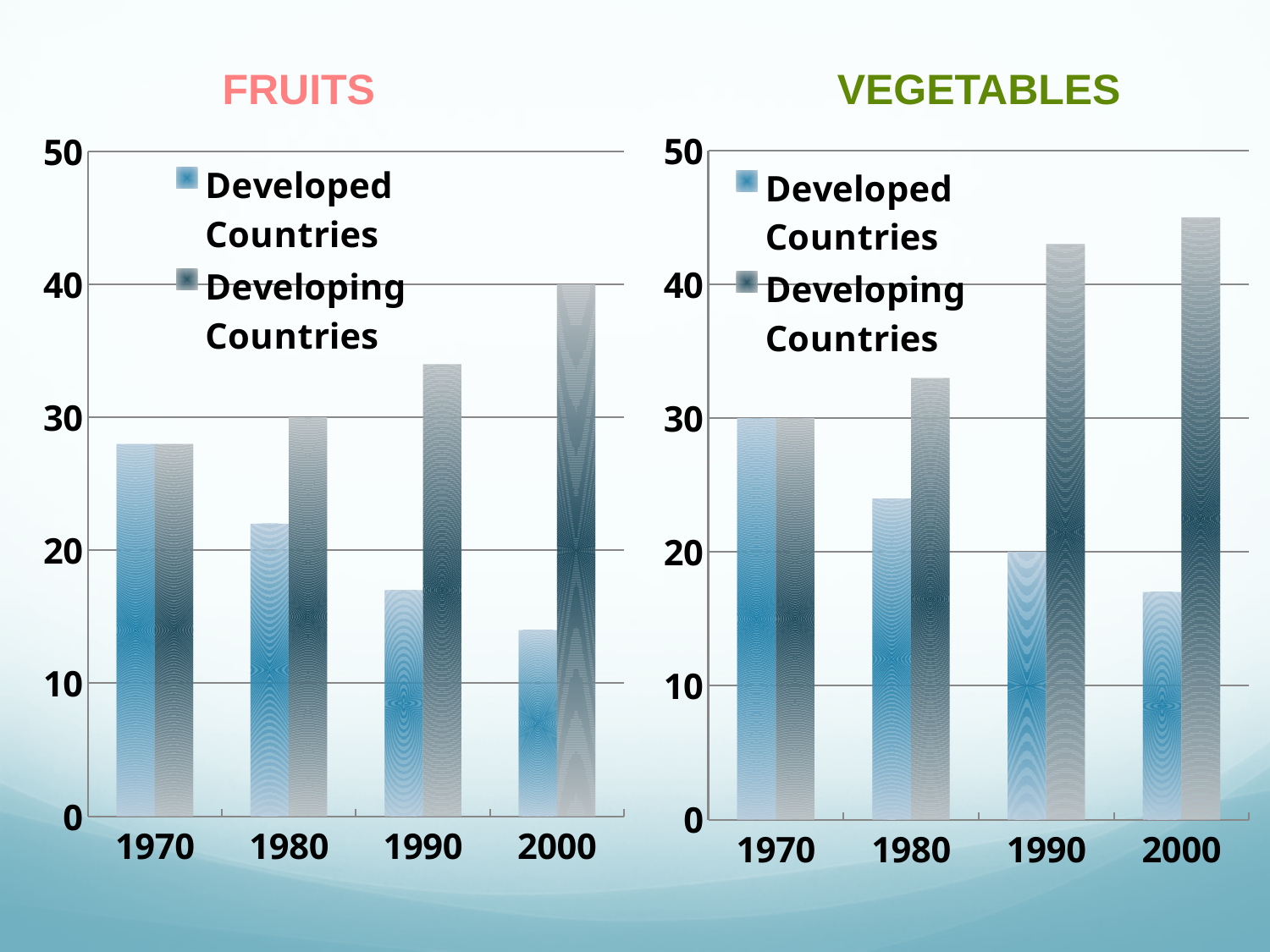
In the VEGETABLES chart, what is the value for Developed Countries in 1990? 20 In the VEGETABLES chart, what is the value for Developed Countries in 1970? 30 In the VEGETABLES chart, which is larger in 1990: Developed Countries or Developing Countries? Developing Countries In the FRUITS chart, in which year is the Developing Countries value highest? 2000 How many series does the legend of the VEGETABLES chart list? 2 In the FRUITS chart, do the Developed Countries values rise or fall from 1970 to 2000? fall In the FRUITS chart, what is the value for Developing Countries in 2000? 40 In the VEGETABLES chart, is the value for Developed Countries in 2000 greater or less than 20? less In the VEGETABLES chart, is the value for Developing Countries in 2000 greater or less than 40? greater In the FRUITS chart, what is the value for Developing Countries in 1980? 30 In the FRUITS chart, is the value for Developing Countries in 1990 greater or less than 30? greater In the FRUITS chart, in which year is the Developed Countries value lowest? 2000